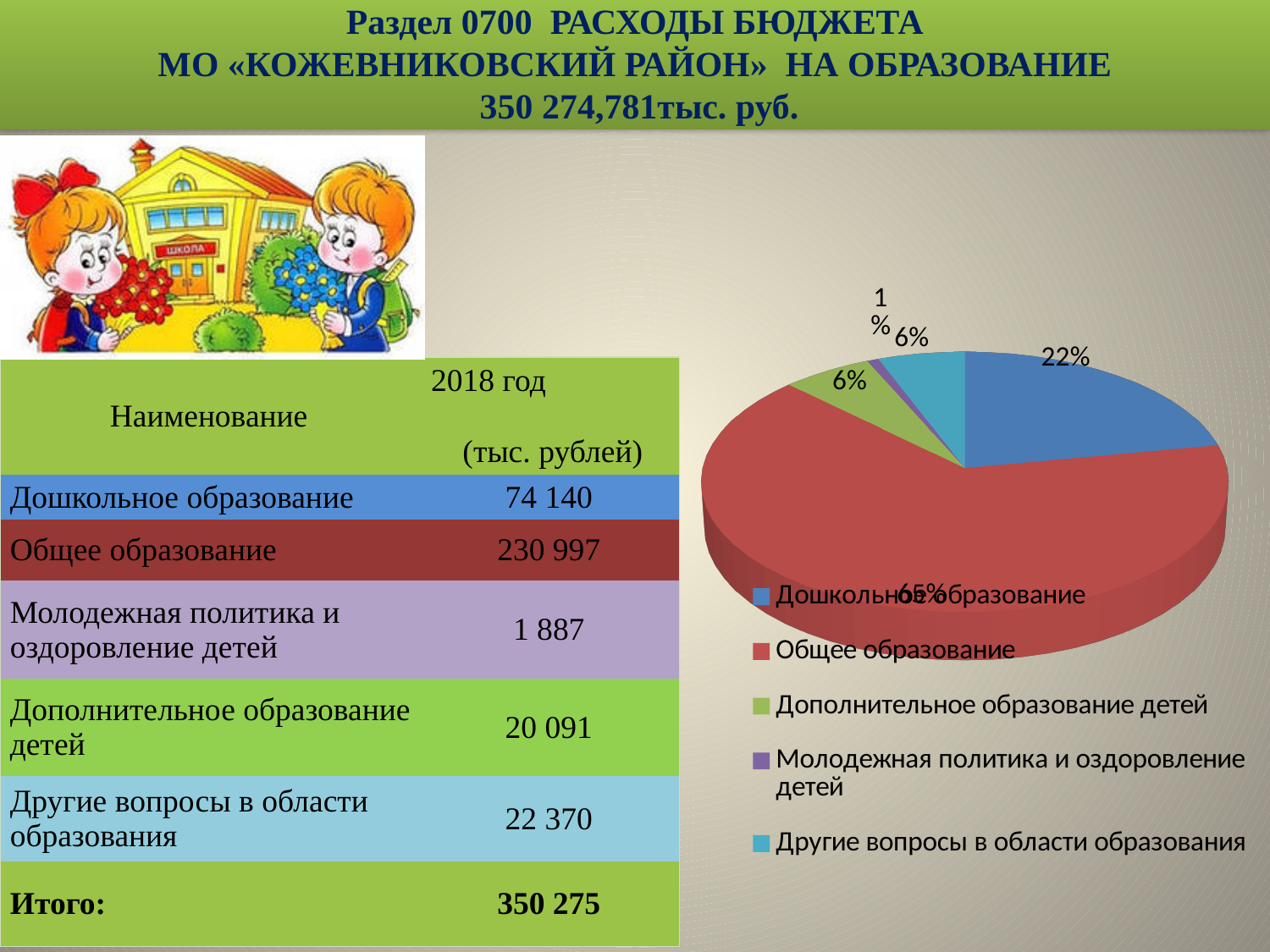
What share of the pie does Дополнительное образование детей take? 6% What kind of chart is shown on the slide? pie chart How many entries does the chart legend list? 5 What colour is the slice for Общее образование? red What share of the pie does Дошкольное образование take? 22% What share of the pie does Другие вопросы в области образования take? 6% How many slices does the pie chart have? 5 Which category has the largest slice of the pie? Общее образование Which category has the smallest slice of the pie? Молодежная политика и оздоровление детей Which slice is larger: Дошкольное образование or Дополнительное образование детей? Дошкольное образование